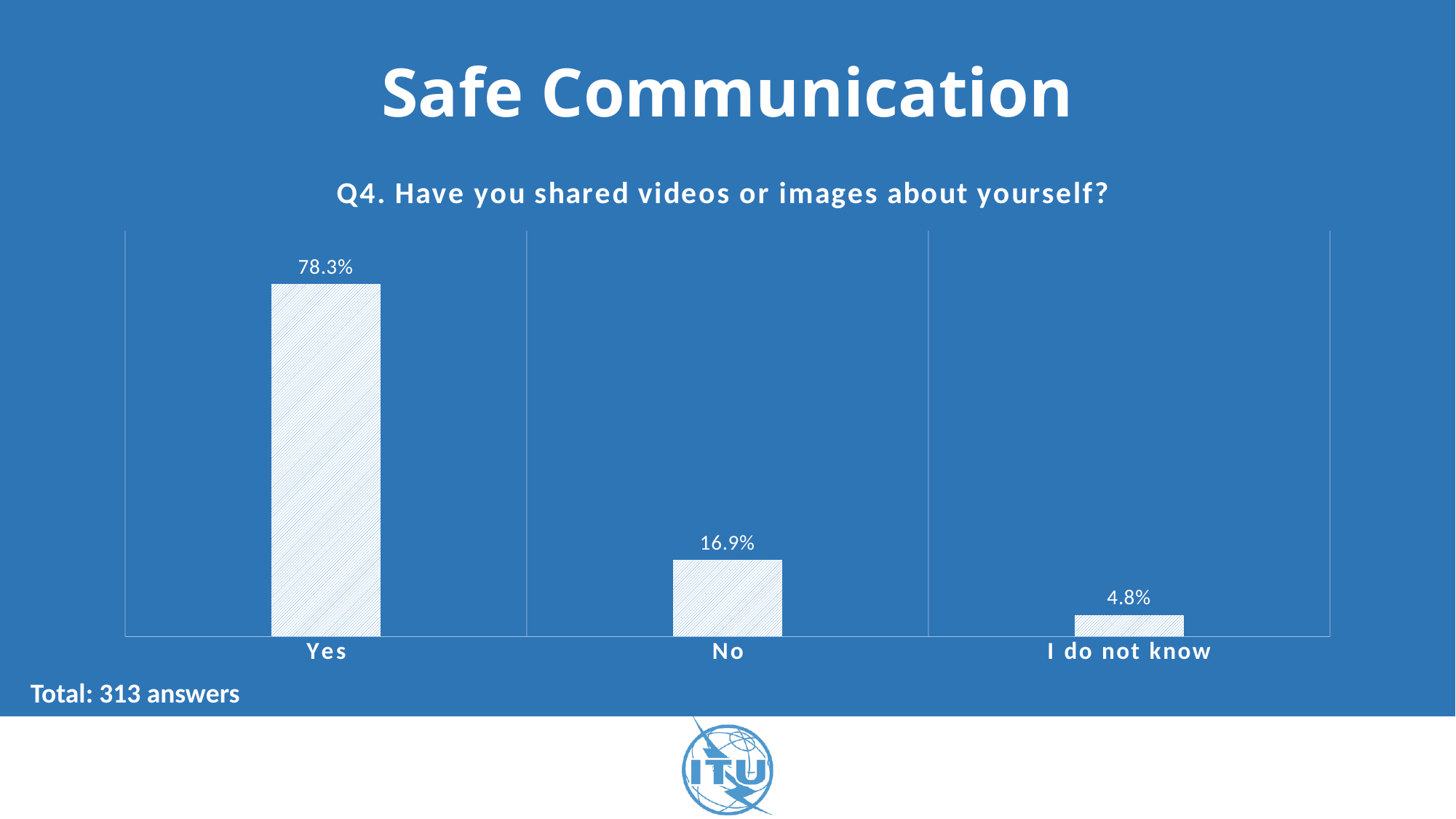
What is the difference in percentage points between the "Yes" and "No" answers? 61.4 What kind of chart is shown on the slide? Bar chart What is the title of the chart? Q4. Have you shared videos or images about yourself? Which is larger, the percentage for "No" or for "I do not know"? No What percentage of respondents answered "No" to Q4? 16.9% What percentage of respondents answered "I do not know" to Q4? 4.8% How many total answers does the slide say the chart is based on? 313 What is the difference in percentage points between the "No" and "I do not know" answers? 12.1 Which answer category has the lowest percentage? I do not know What percentage of respondents answered "Yes" to Q4? 78.3% How many answer categories are shown in the chart? 3 Which answer category has the highest percentage? Yes